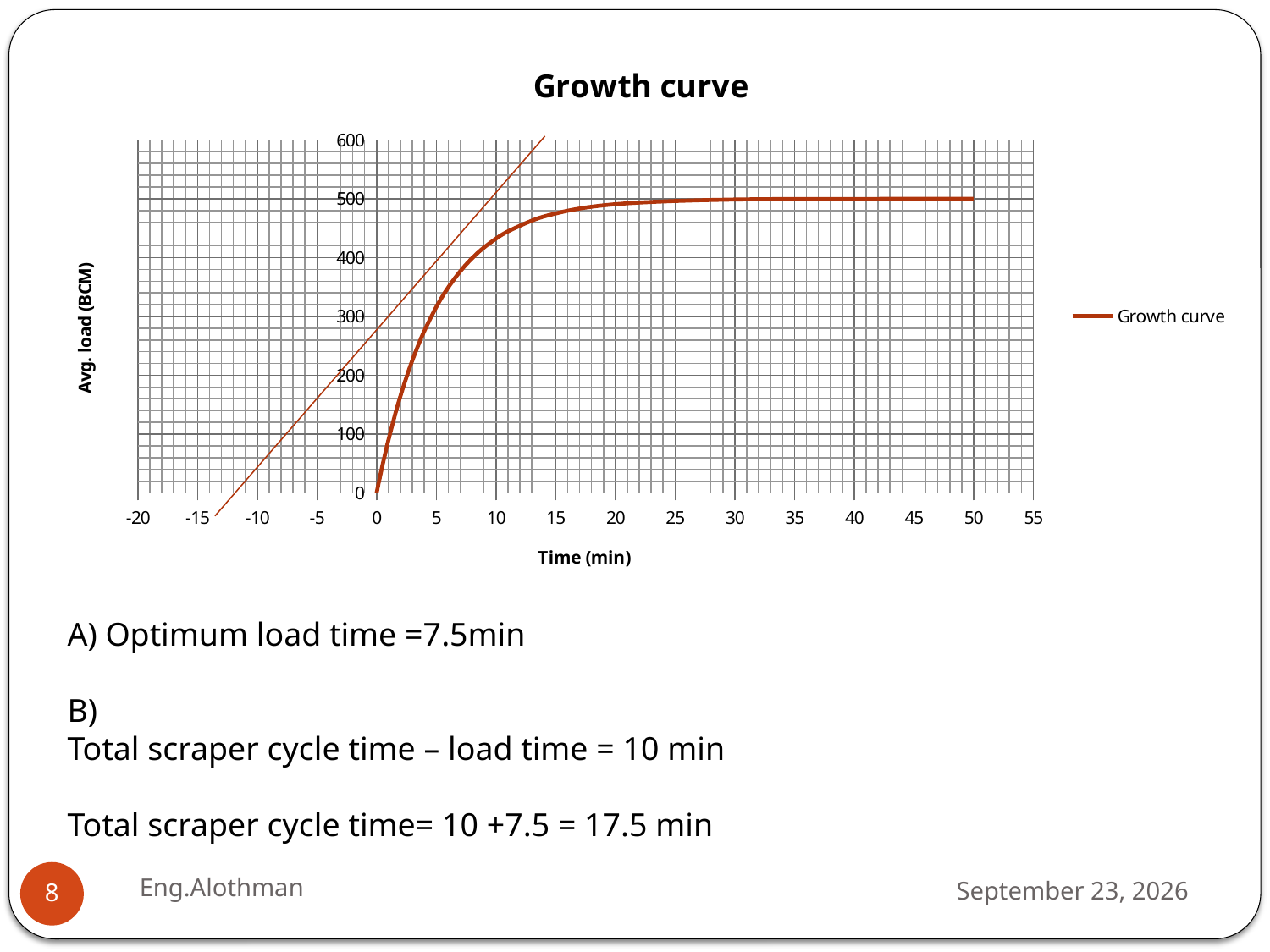
Is the value of the Growth curve at 10 min greater or less than 400? greater What is the label of the y axis? Avg. load (BCM) Is the value of the Growth curve at 1 min greater or less than 200? less What kind of chart is shown on the slide? line chart How many series does the legend list? 1 Which is larger, the Growth curve value at 5 min or at 20 min? 20 min What is the title of the chart? Growth curve Is the value of the Growth curve at 5 min greater or less than 300? greater Does the Growth curve rise or fall as time increases from 0 to 50 min? rise What value does the Growth curve level off at by 50 min? 500 What is the value of the Growth curve at time 0 min? 0 What is the highest value shown on the y axis? 600